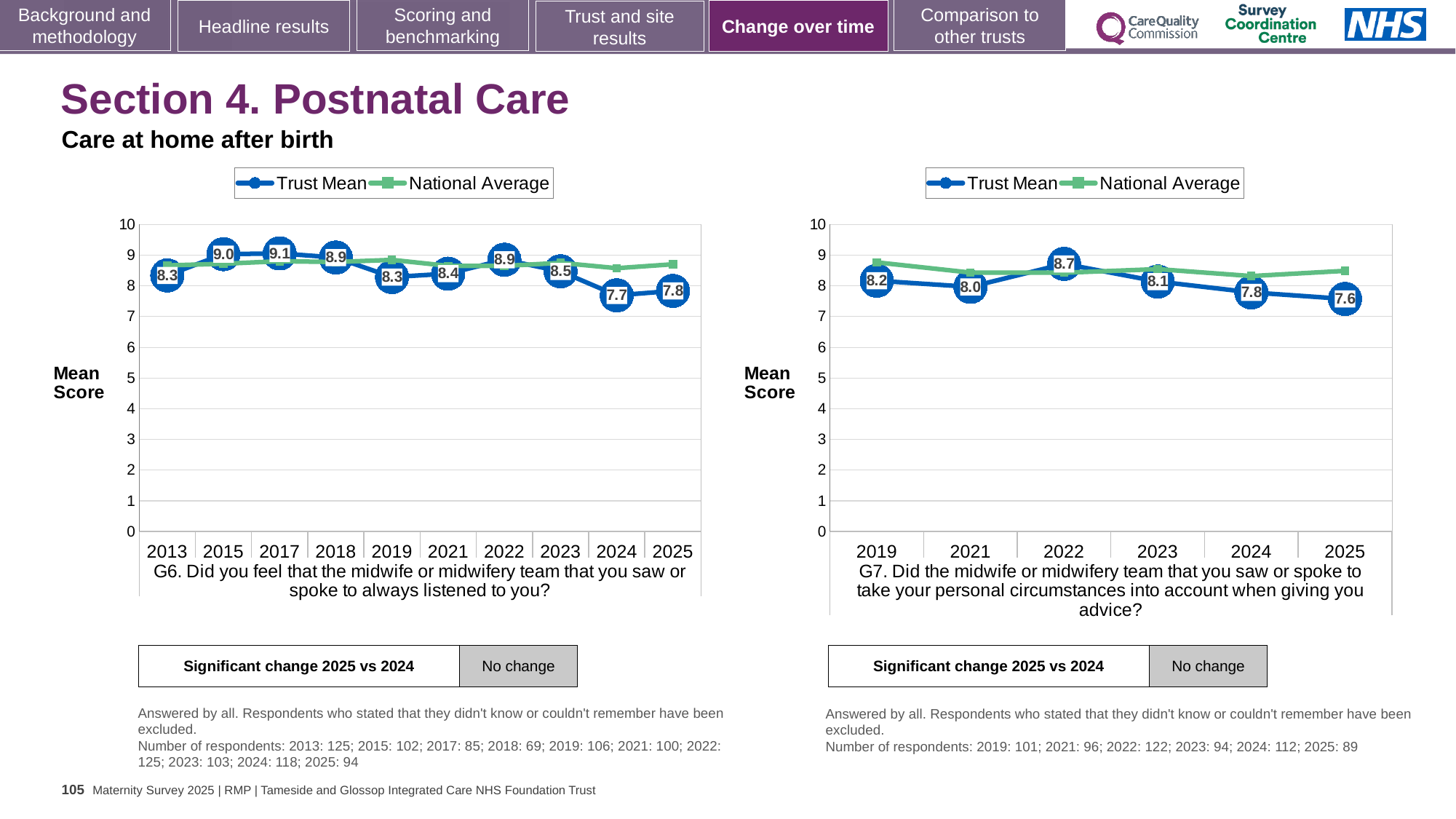
In the G7 chart (right), is the National Average for 2019 greater or less than 8? greater In the G6 chart (left), which year has the lowest Trust Mean score? 2024 How many years are plotted in the G7 chart (right)? 6 In the G7 chart (right), is the Trust Mean score for 2019 or 2021 larger? 2019 In the G6 chart (left), what is the Trust Mean score for 2017? 9.1 In the G7 chart (right), which year has the lowest Trust Mean score? 2025 In the G6 chart (left), which year has the highest Trust Mean score? 2017 In the G7 chart (right), what is the Trust Mean score for 2022? 8.7 In the G7 chart (right), what is the Trust Mean score for 2025? 7.6 In the G6 chart (left), what is the difference between the Trust Mean scores for 2017 and 2025? 1.3 How many series does the legend of the G6 chart (left) list? 2 In the G6 chart (left), what is the Trust Mean score for 2024? 7.7